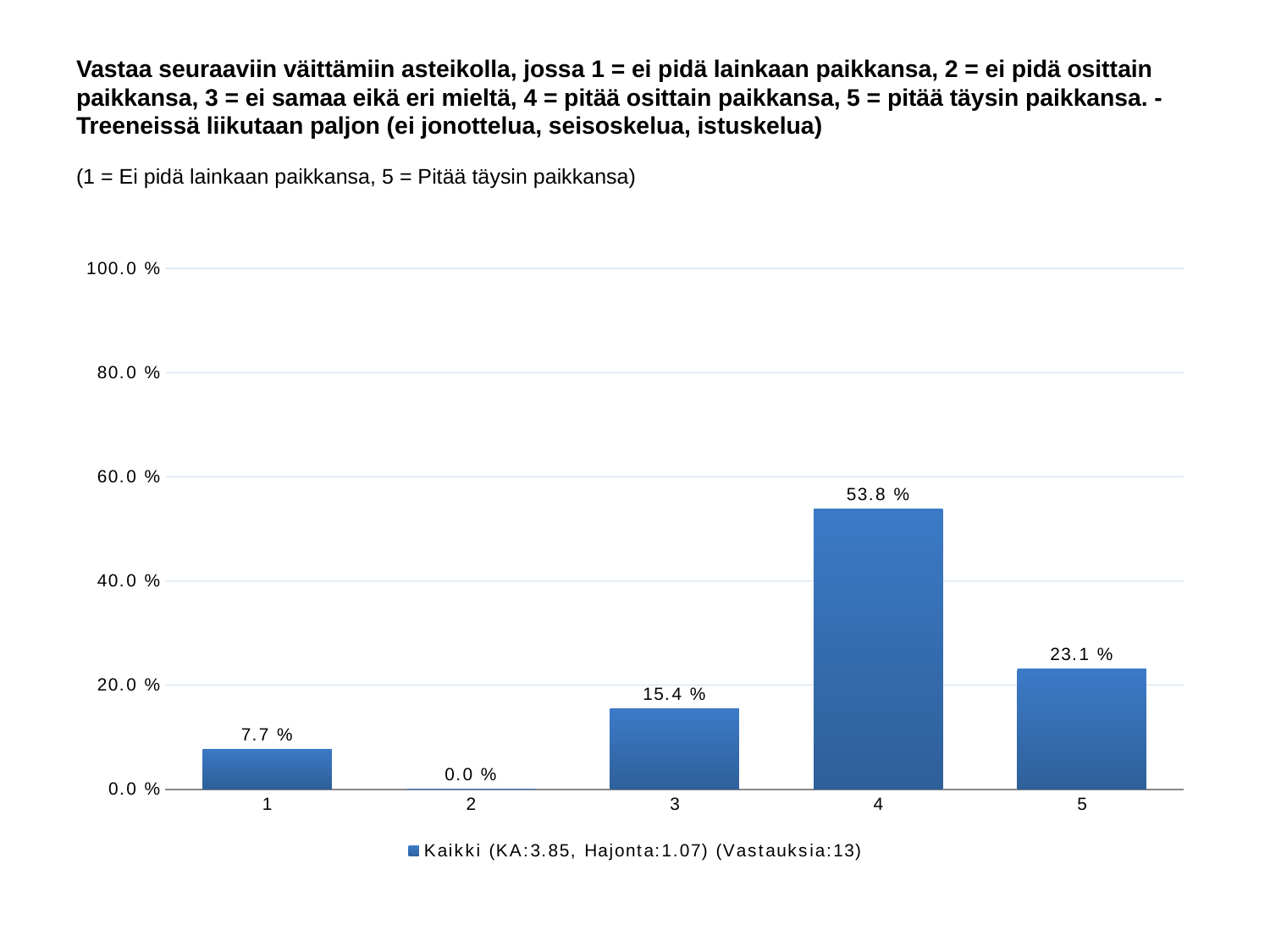
What is the value for category 1? 7.7 % What is the value for category 5? 23.1 % Which category has the highest value? 4 What kind of chart is shown on the slide? bar chart Which category has the lowest value? 2 What is the number of responses (Vastauksia) given in the legend? 13 What is the value for category 4? 53.8 % How many series does the legend list? 1 How many categories are shown on the x axis? 5 What is the difference between the values for category 4 and category 5? 30.7 % Is the value for category 4 greater or less than 40.0 %? greater Which is larger, the value for category 3 or the value for category 5? 5